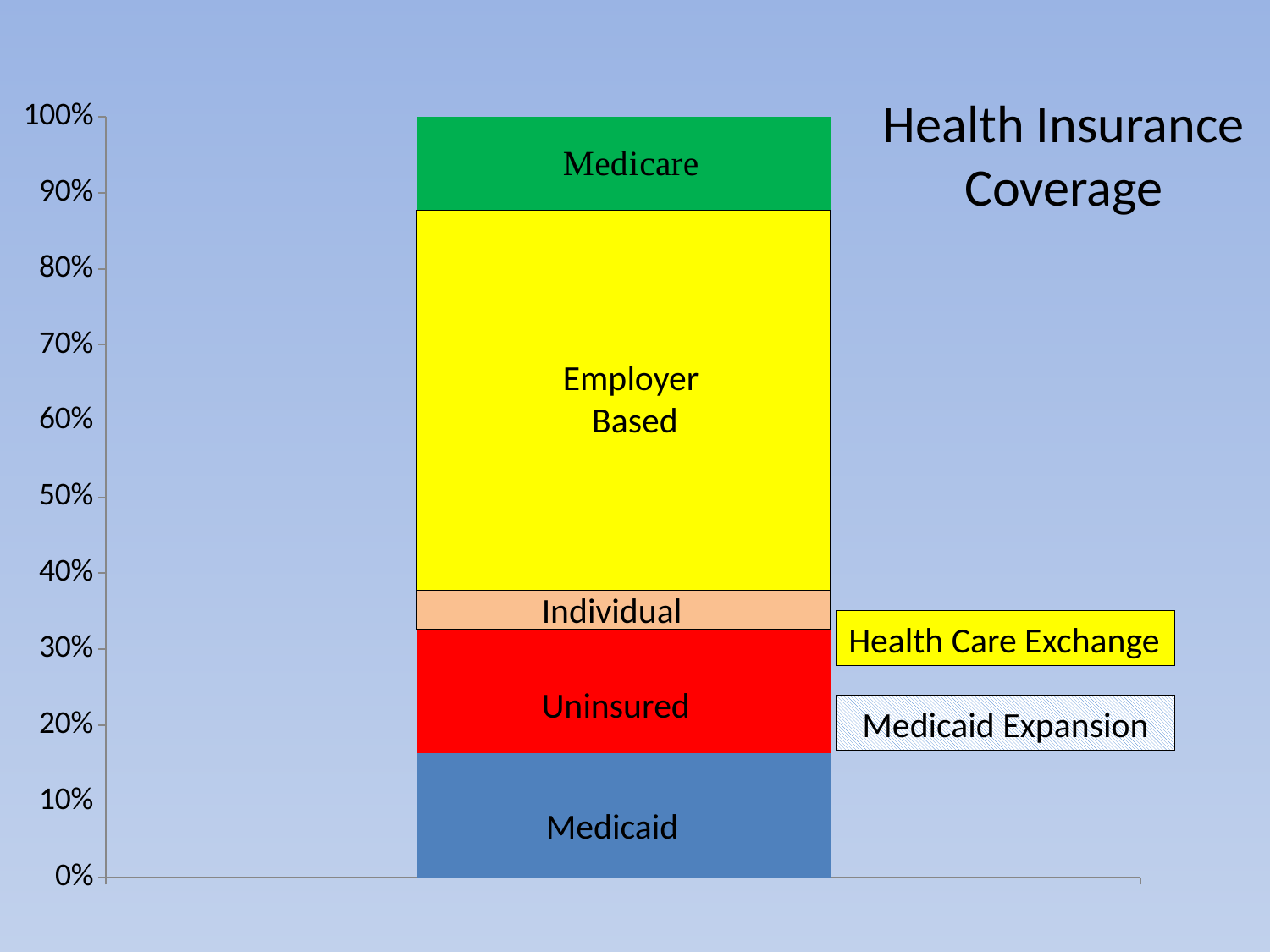
What kind of chart is shown on the slide? Stacked bar chart Is the top of the Employer Based segment greater or less than 80%? greater Is the top of the Medicaid segment greater or less than 20%? less What is the title of the chart? Health Insurance Coverage Which segment is at the bottom of the stacked bar? Medicaid What is the total height of the stacked bar? 100% Which segment is at the top of the stacked bar? Medicare Which segment of the stacked bar is the smallest? Individual Which segment of the stacked bar is the largest? Employer Based Which segment is larger, Medicare or Individual? Medicare Which segment is larger, Employer Based or Uninsured? Employer Based How many segments make up the stacked bar? 5